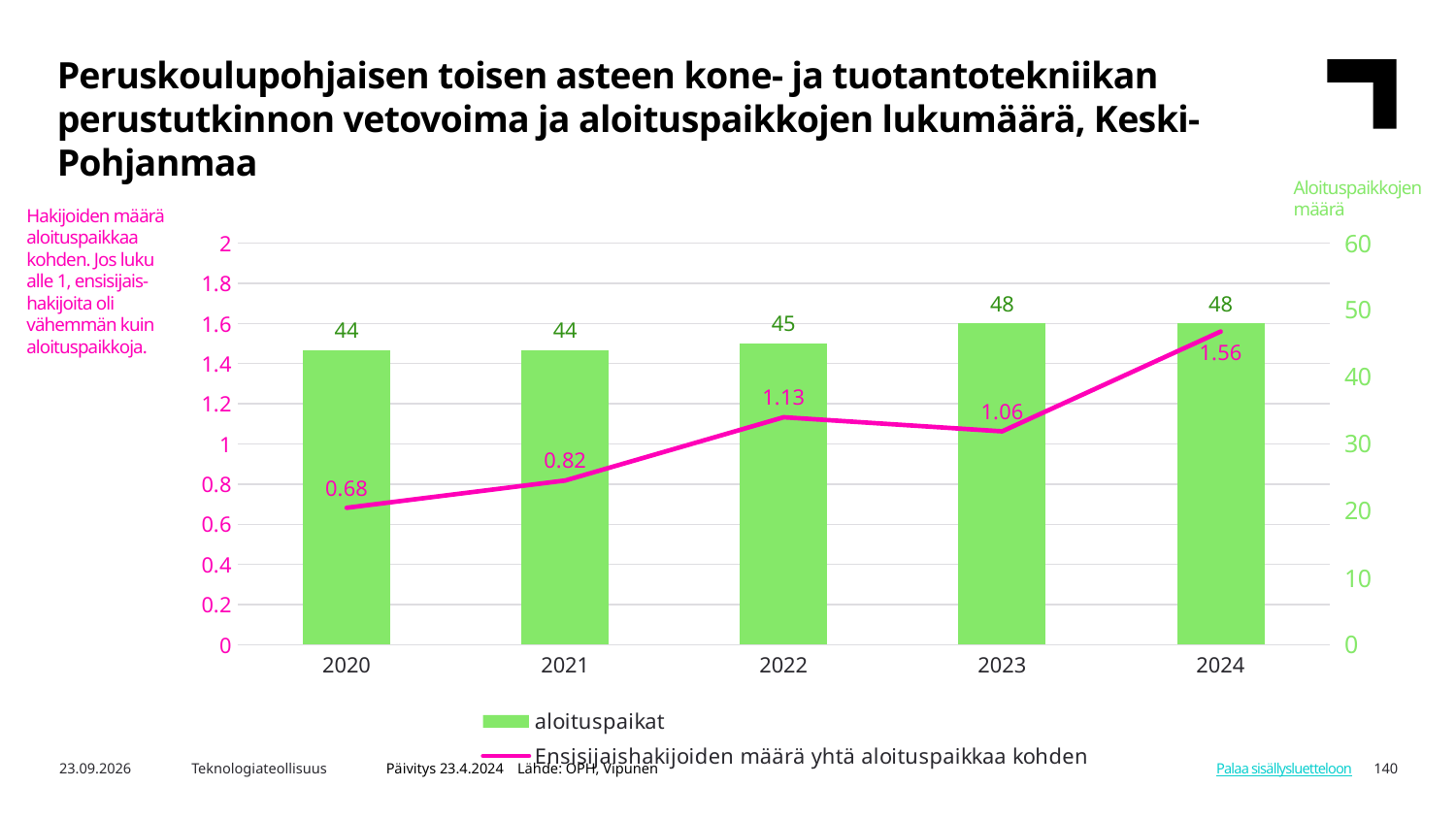
What is the value of aloituspaikat in 2022? 45 Which year has more aloituspaikat, 2022 or 2023? 2023 What colour are the aloituspaikat bars? Green What is the value of Ensisijaishakijoiden määrä yhtä aloituspaikkaa kohden in 2020? 0.68 In which year is Ensisijaishakijoiden määrä yhtä aloituspaikkaa kohden highest? 2024 What is the difference in aloituspaikat between 2024 and 2020? 4 In which year is Ensisijaishakijoiden määrä yhtä aloituspaikkaa kohden lowest? 2020 What is the difference in Ensisijaishakijoiden määrä yhtä aloituspaikkaa kohden between 2022 and 2021? 0.31 How many years are shown on the x axis? 5 How many series does the legend list? 2 Is the value of Ensisijaishakijoiden määrä yhtä aloituspaikkaa kohden in 2023 greater or less than 1? greater What is the value of Ensisijaishakijoiden määrä yhtä aloituspaikkaa kohden in 2024? 1.56